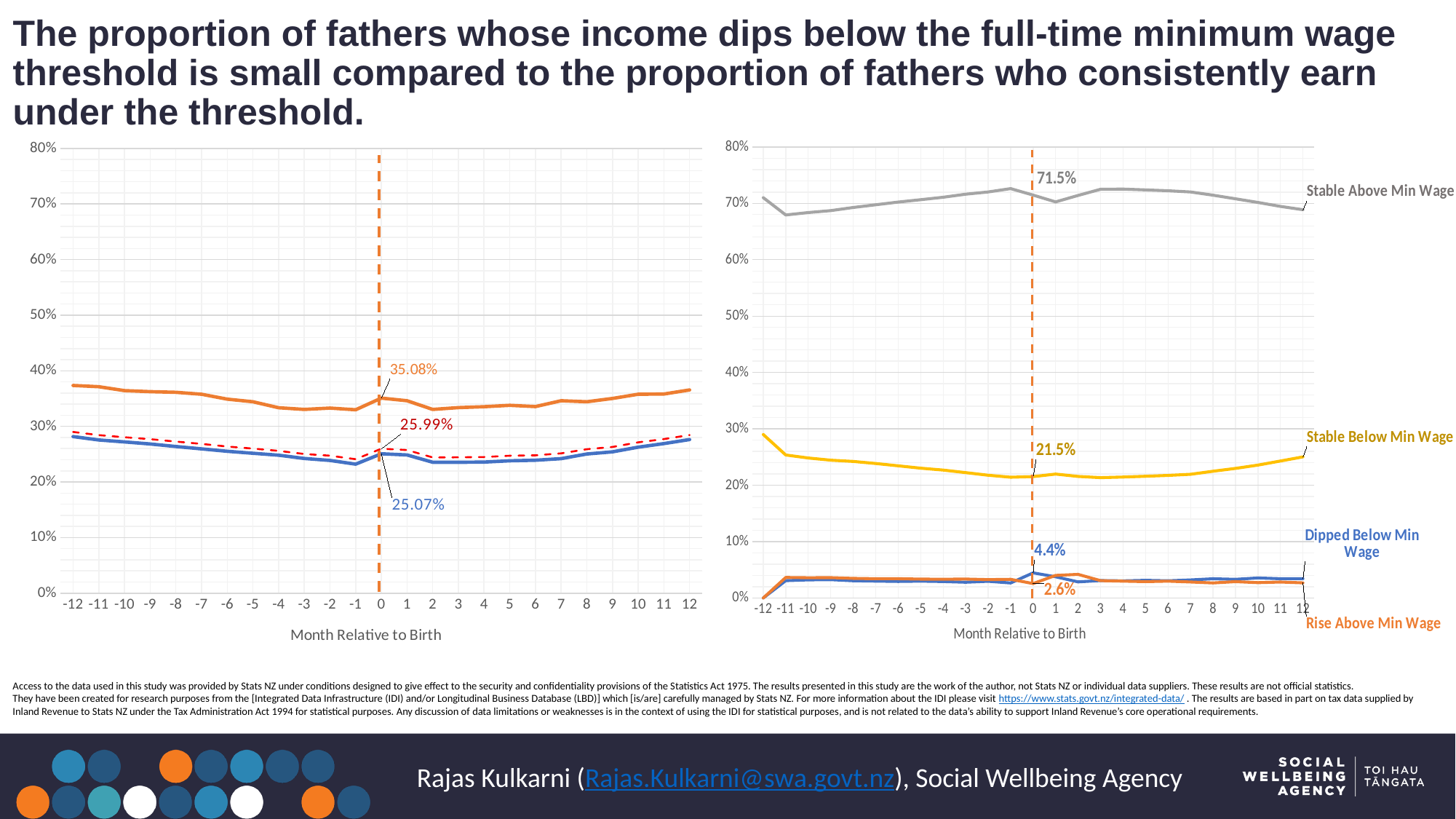
How many series are labelled on the right chart? 4 On the right chart, what is the labelled value for Rise Above Min Wage at month 0? 2.6% On the right chart, what is the difference between the Stable Above Min Wage and Stable Below Min Wage values at month 0? 50 percentage points On the left chart, is the value of the orange line at month -12 greater or less than 30%? greater On the right chart, which series has the highest value at month 0? Stable Above Min Wage On the left chart, what is the labelled value of the blue line at month 0? 25.07% On the right chart, what is the labelled value for Stable Below Min Wage at month 0? 21.5% What type of chart is shown on the left? Line chart On the left chart, what is the labelled value of the orange line at month 0? 35.08% On the right chart, what is the labelled value for Stable Above Min Wage at month 0? 71.5% On the right chart, what is the labelled value for Dipped Below Min Wage at month 0? 4.4% On the right chart, which series has the lowest value at month 0? Rise Above Min Wage